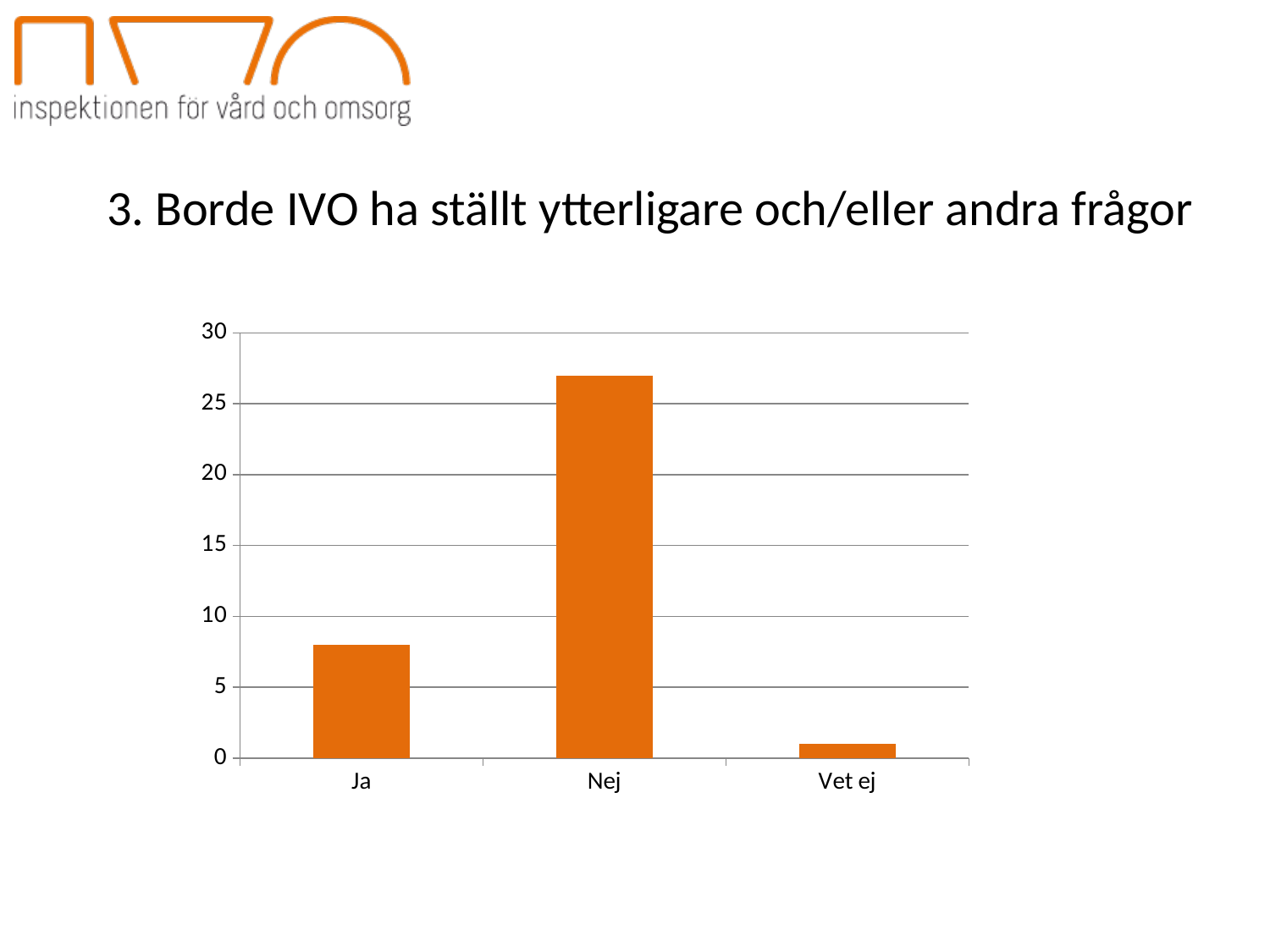
Which category has the lowest bar in the chart? Vet ej Is the value for Vet ej greater or less than 5? less Which is larger, the value for Ja or the value for Vet ej? Ja Is the value for Nej greater or less than 25? greater Is the value for Ja greater or less than 10? less How many categories are shown on the x axis of the chart? 3 What colour are the bars in the chart? orange What is the title of the chart on the slide? 3. Borde IVO ha ställt ytterligare och/eller andra frågor Which is larger, the value for Ja or the value for Nej? Nej What kind of chart is shown on the slide? bar chart Which category has the highest bar in the chart? Nej